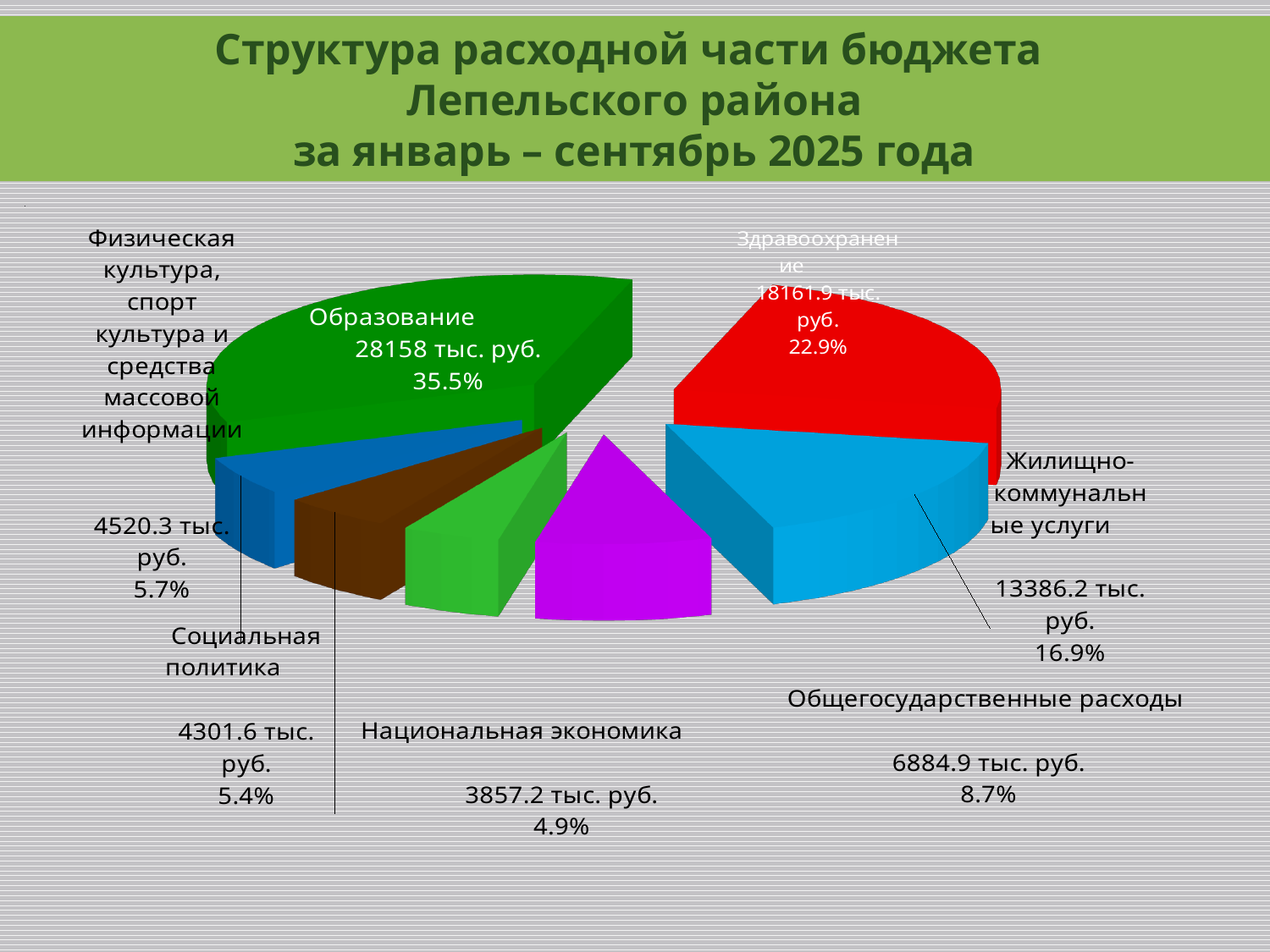
What percentage is shown for Общегосударственные расходы? 8.7% Which category has the largest share of the budget expenditure? Образование Which category has the smallest share of the budget expenditure? Национальная экономика What is the difference in percentage points between Образование and Здравоохранение? 12.6 What kind of chart is shown on the slide? pie chart What is the value for Физическая культура, спорт культура и средства массовой информации? 4520.3 тыс. руб. What period does the chart title say the budget expenditure structure covers? январь – сентябрь 2025 года How many categories (slices) does the pie chart show? 7 Which is larger: the value for Социальная политика or the value for Национальная экономика? Социальная политика What share of the pie does Здравоохранение take? 22.9% What is the value for Образование? 28158 тыс. руб. What is the value for Жилищно-коммунальные услуги? 13386.2 тыс. руб.